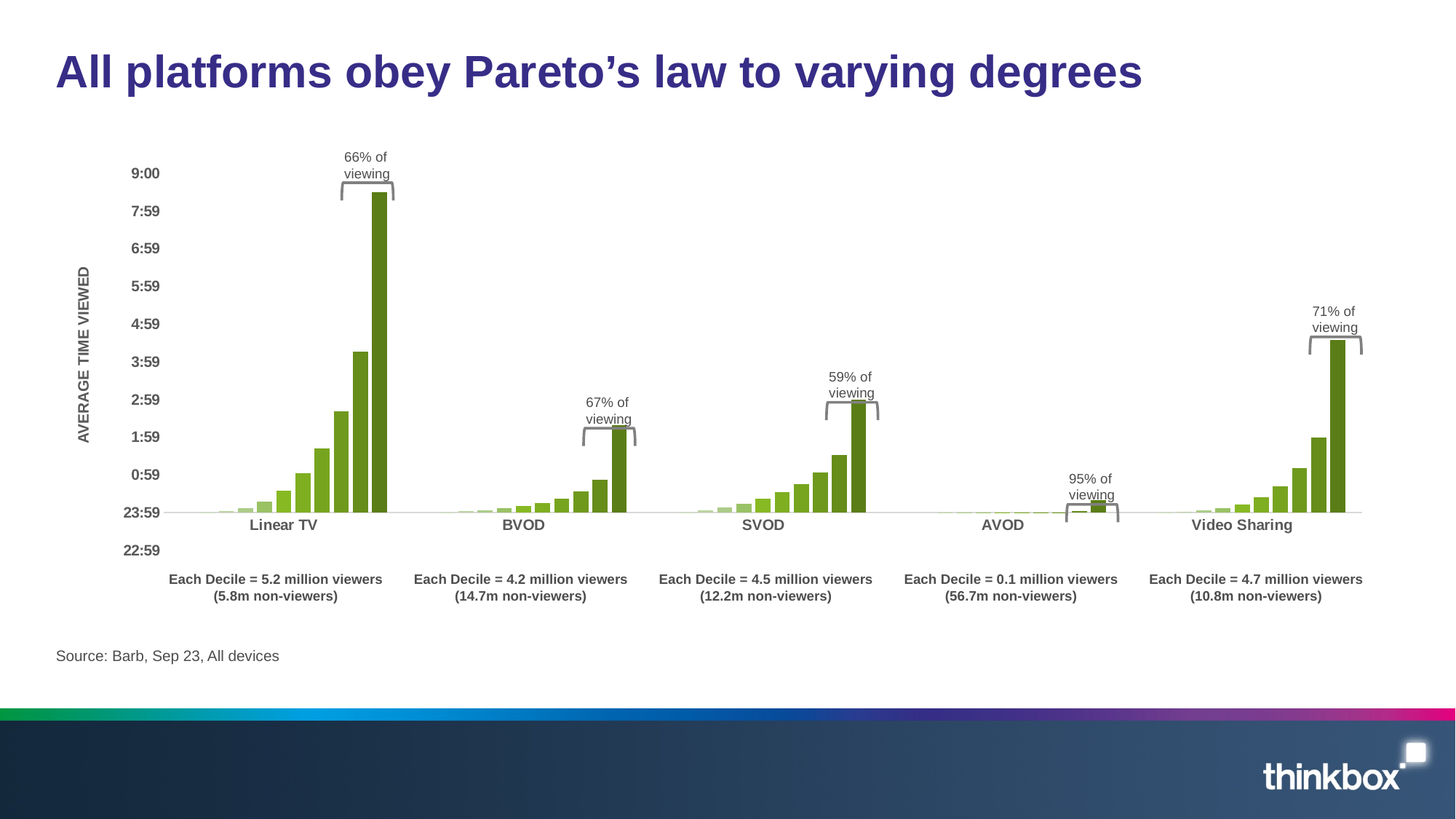
Is the top-decile bar for BVOD greater or less than 2:59 on the axis? less What share of viewing does the top decile account for on Linear TV? 66% of viewing Within each platform, do the bars rise or fall from left to right across the deciles? Rise What is the difference in percentage points between the top-decile share of viewing for AVOD and for SVOD? 36 percentage points How many platforms are shown along the x axis of the chart? 5 Which platform has the highest top-decile share of viewing? AVOD What share of viewing does the top decile account for on AVOD? 95% of viewing What kind of chart is shown on the slide? Bar chart Which has the taller top-decile bar, Linear TV or Video Sharing? Linear TV Is the top-decile bar for Linear TV greater or less than 7:59 on the axis? greater Which platform has the lowest top-decile share of viewing? SVOD What is the title of the y axis? AVERAGE TIME VIEWED